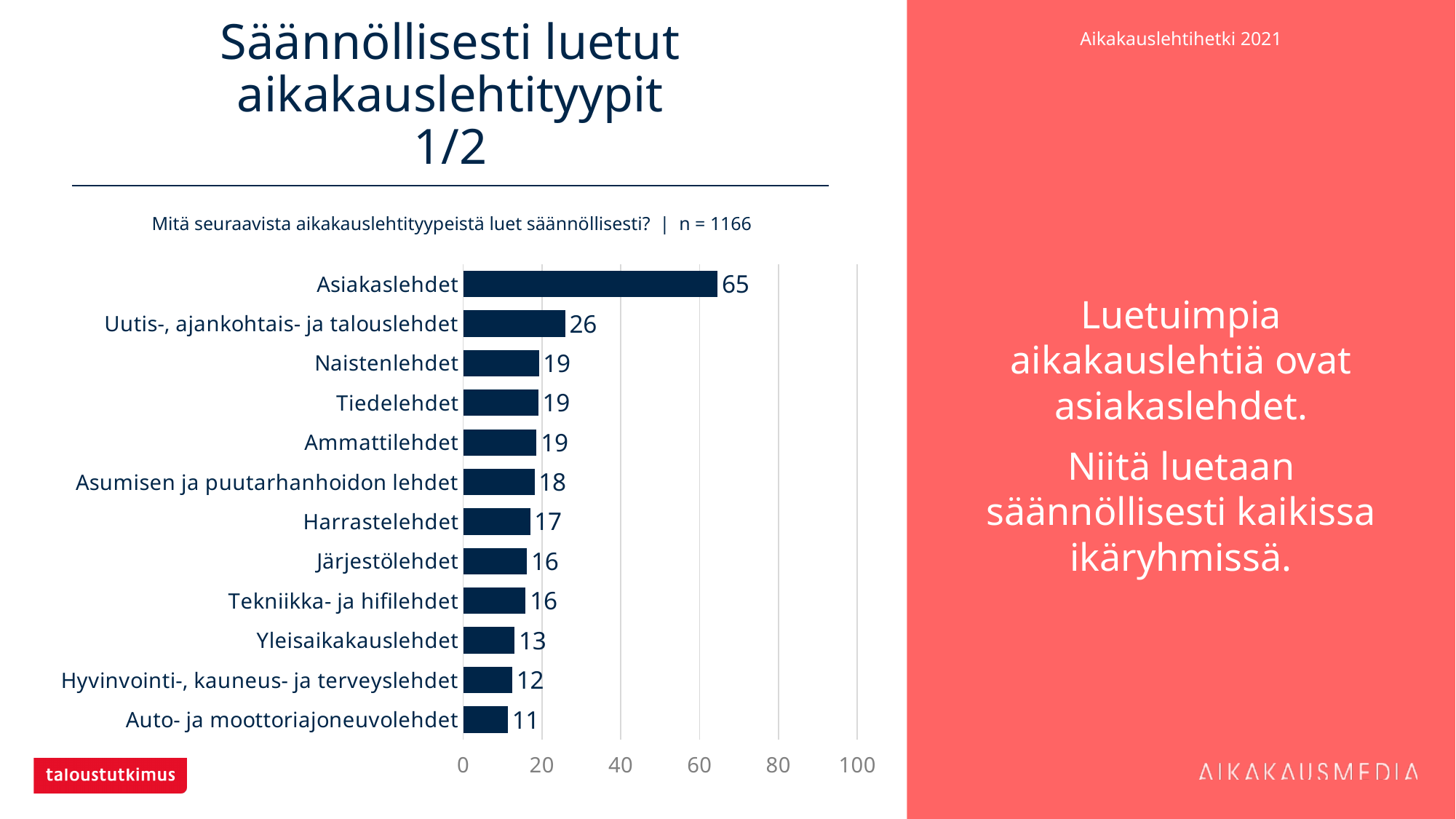
What is the difference between the values for Asiakaslehdet and Uutis-, ajankohtais- ja talouslehdet? 39 Which is larger, the value for Naistenlehdet or the value for Yleisaikakauslehdet? Naistenlehdet How many categories are shown in the chart? 12 Which category has the highest value? Asiakaslehdet What is the value for Uutis-, ajankohtais- ja talouslehdet? 26 What kind of chart is shown on the slide? bar chart What is the value for Asiakaslehdet? 65 Which category has the lowest value? Auto- ja moottoriajoneuvolehdet What is the value for Harrastelehdet? 17 What is the value for Hyvinvointi-, kauneus- ja terveyslehdet? 12 Is the value for Asiakaslehdet greater or less than 60? greater What is the sample size (n) stated above the chart? n = 1166